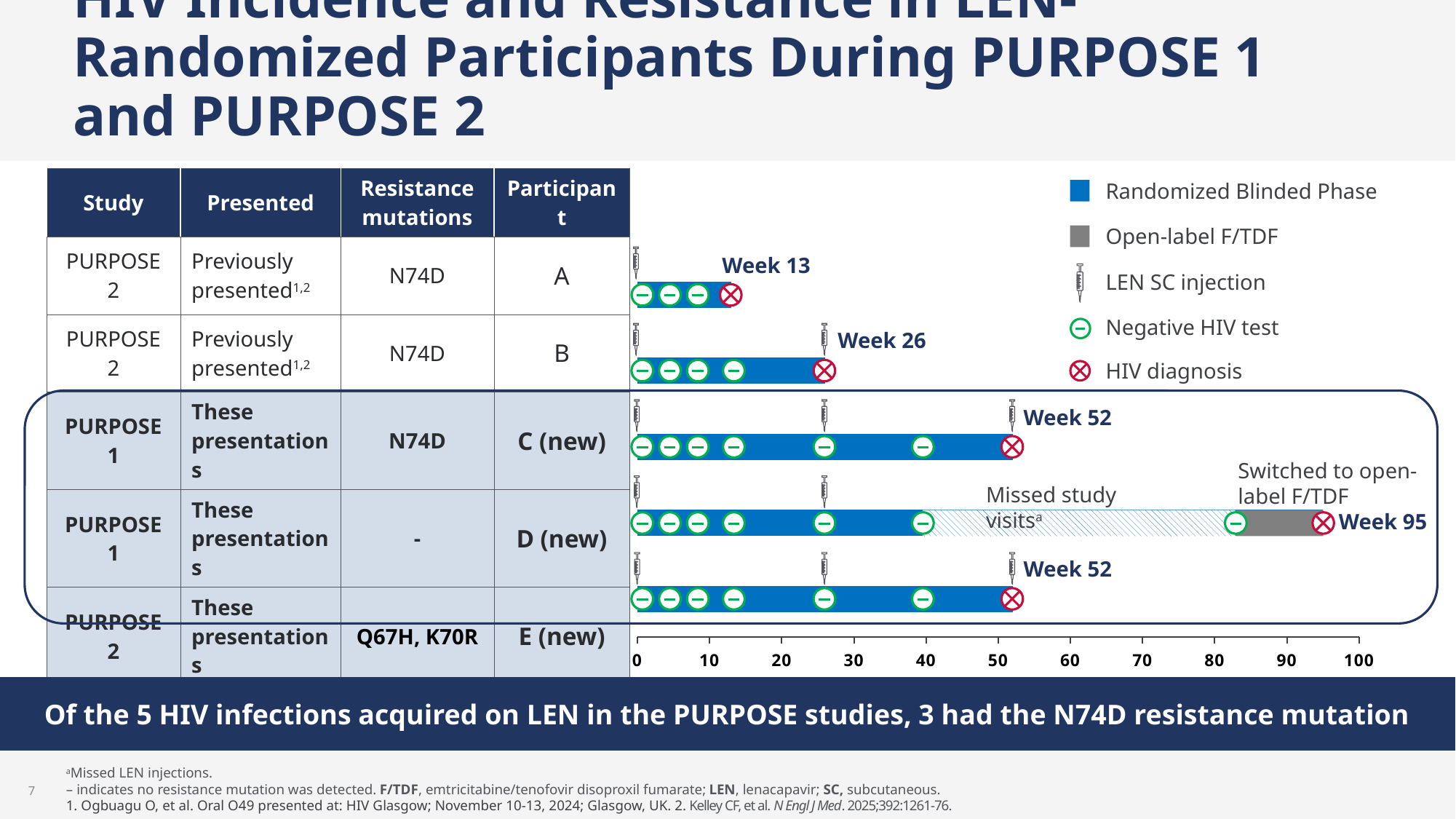
How many weeks later was participant B diagnosed than participant A? 13 weeks Who was diagnosed with HIV later, participant B or participant C? Participant C Which participant had the earliest HIV diagnosis on the timeline? A At what week was participant C (new) diagnosed with HIV? Week 52 How many entries does the chart legend list? 5 At what week was participant D (new) diagnosed with HIV? Week 95 How many weeks later was participant D diagnosed than participant C? 43 weeks How many participant timelines are plotted on the chart? 5 At what week was participant A diagnosed with HIV? Week 13 At what week was participant B diagnosed with HIV? Week 26 According to the legend, what does the grey bar segment represent? Open-label F/TDF Which participant had the latest HIV diagnosis on the timeline? D (new)